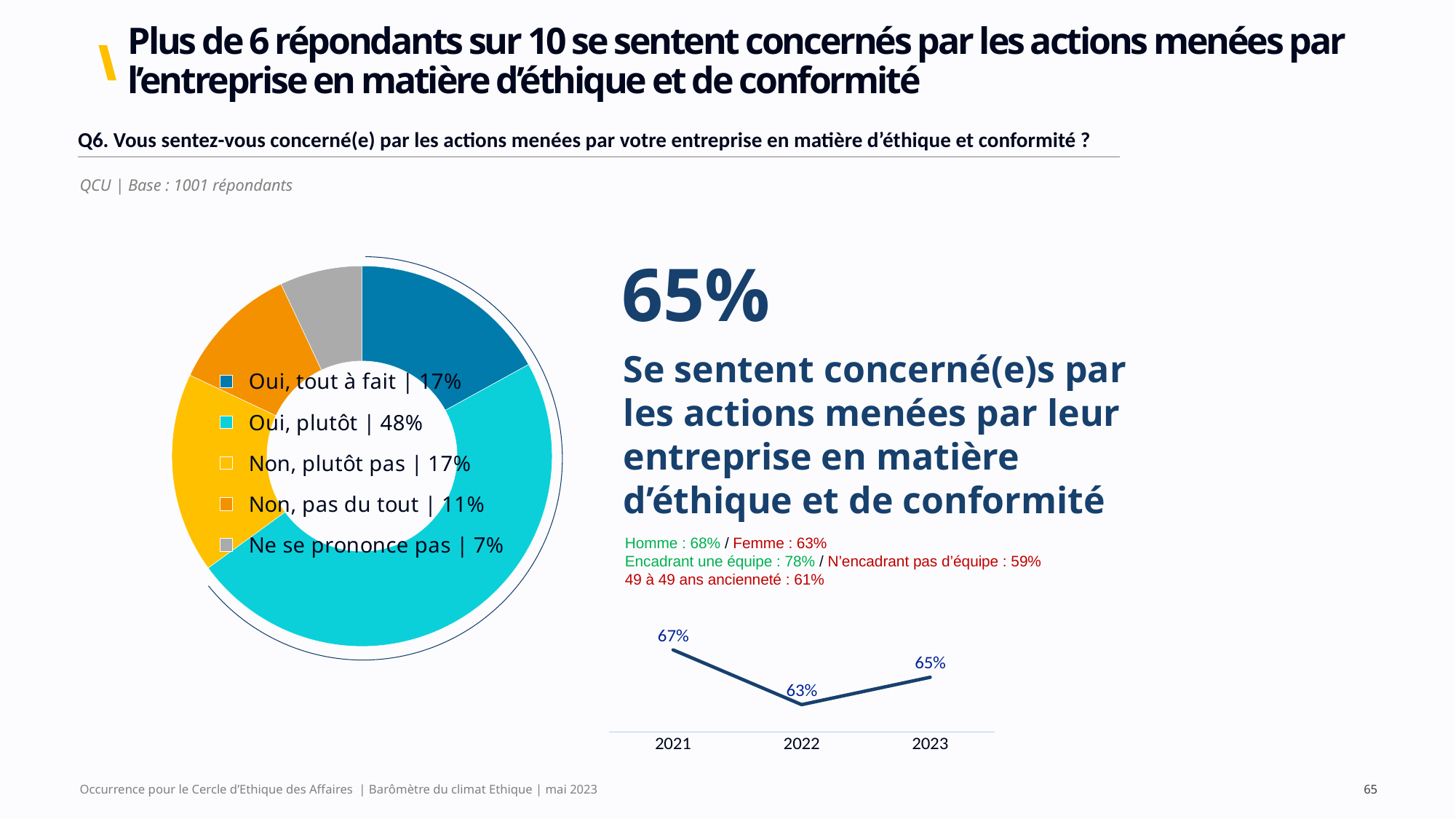
In the line chart at the bottom right, which year has the highest value? 2021 In the line chart at the bottom right, what is the difference between the 2021 and 2022 values? 4% In the line chart at the bottom right, how many years are plotted? 3 In the doughnut chart on the left, which category has the largest share? Oui, plutôt In the line chart at the bottom right, what is the value for 2022? 63% How many categories does the doughnut chart on the left show? 5 In the doughnut chart on the left, which is larger: "Non, pas du tout" or "Ne se prononce pas"? Non, pas du tout In the doughnut chart on the left, which category has the smallest share? Ne se prononce pas In the doughnut chart on the left, what is the difference between "Oui, plutôt" and "Oui, tout à fait"? 31% What kind of chart is shown on the left of the slide? Doughnut chart In the doughnut chart on the left, what percentage is shown for "Oui, plutôt"? 48% In the doughnut chart on the left, what percentage is shown for "Non, pas du tout"? 11%